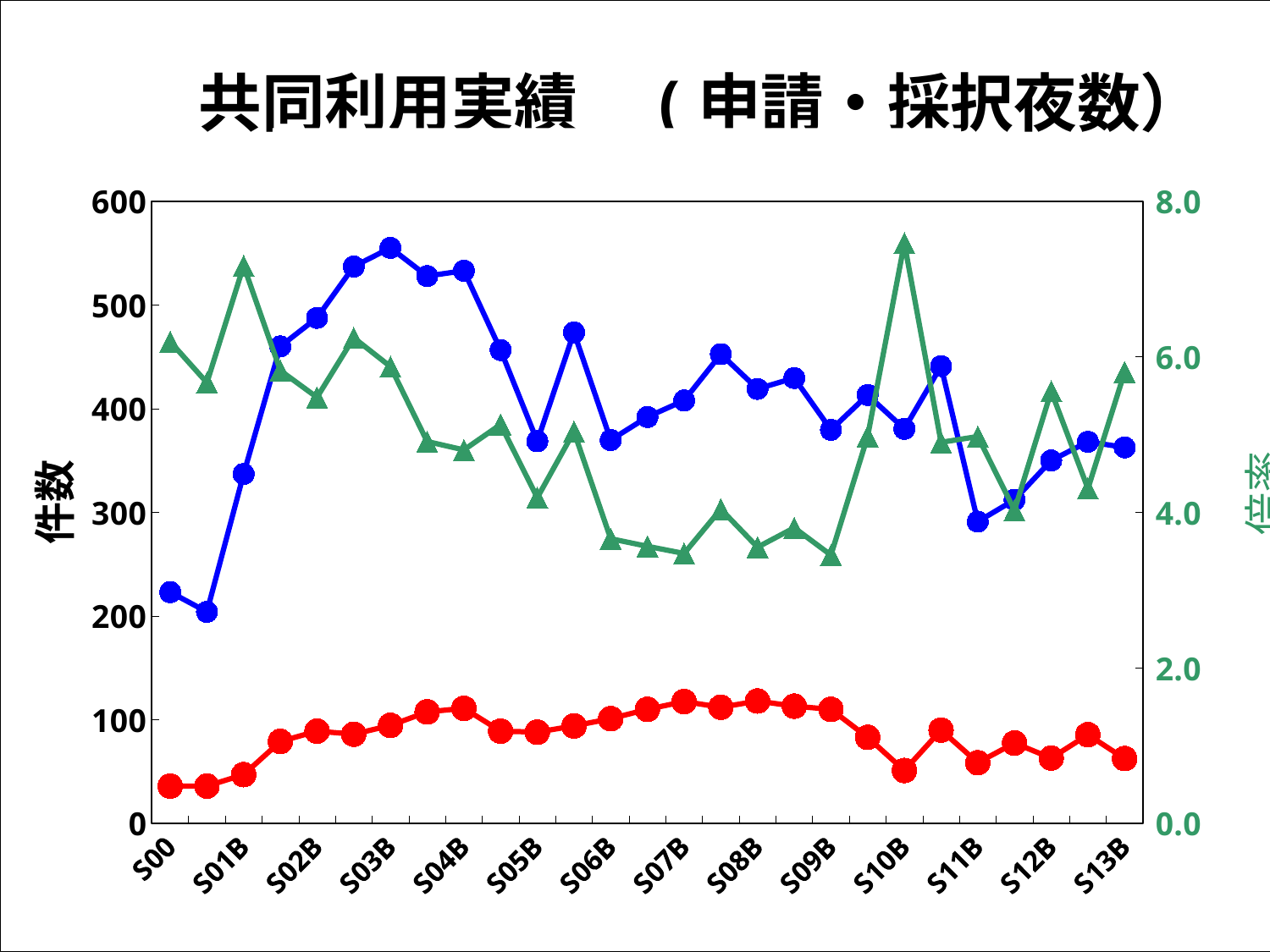
What is the title of the chart? 共同利用実績 （申請・採択夜数） Is the value of the green triangle series at S08B greater or less than 4.0 on the right axis? less Is the value of the blue circle series at S03B greater or less than 500? greater Which is larger for the blue circle series: the value at S03B or the value at S11B? S03B What is the label of the left vertical axis? 件数 How many category labels are printed along the x axis? 14 At which x-axis label does the blue circle series reach its highest value? S03B What kind of chart is shown on the slide? line chart Is the value of the blue circle series at S00 greater or less than 300? less How many data series are plotted on the chart? 3 At which x-axis label does the green triangle series reach its highest value? S10B